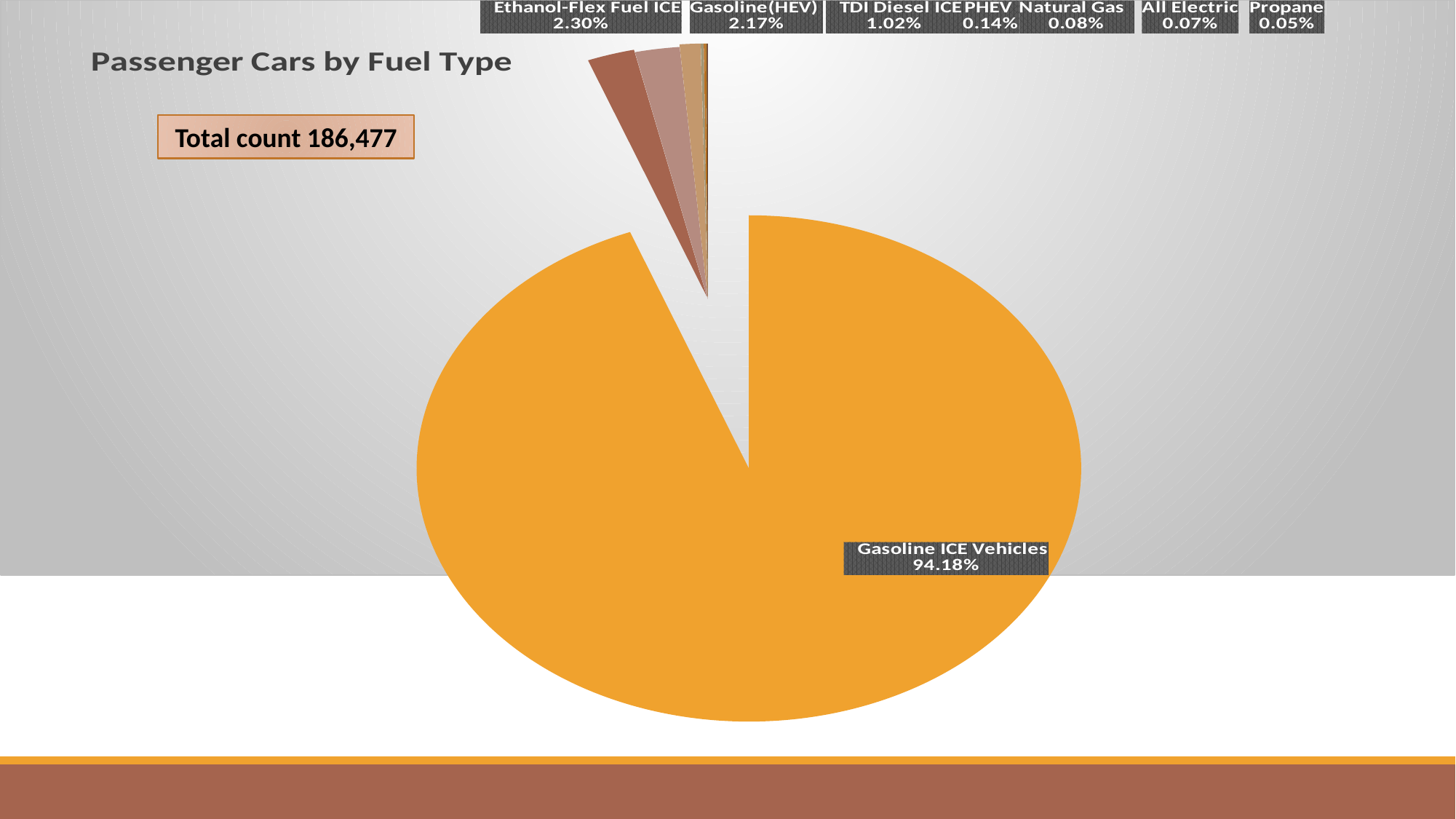
Which fuel type has the largest share of passenger cars? Gasoline ICE Vehicles What share of passenger cars are Gasoline (HEV)? 2.17% What share of passenger cars are Ethanol-Flex Fuel ICE? 2.30% Which has a larger share, PHEV or Natural Gas? PHEV How many fuel type categories are shown in the pie chart? 8 What is the difference in share between Ethanol-Flex Fuel ICE and Gasoline (HEV)? 0.13% What share of passenger cars are TDI Diesel ICE? 1.02% What kind of chart is shown on the slide? Pie chart What share of passenger cars are Gasoline ICE Vehicles? 94.18% What is the title of the chart? Passenger Cars by Fuel Type Which fuel type has the smallest share of passenger cars? Propane What share of passenger cars are Propane? 0.05%